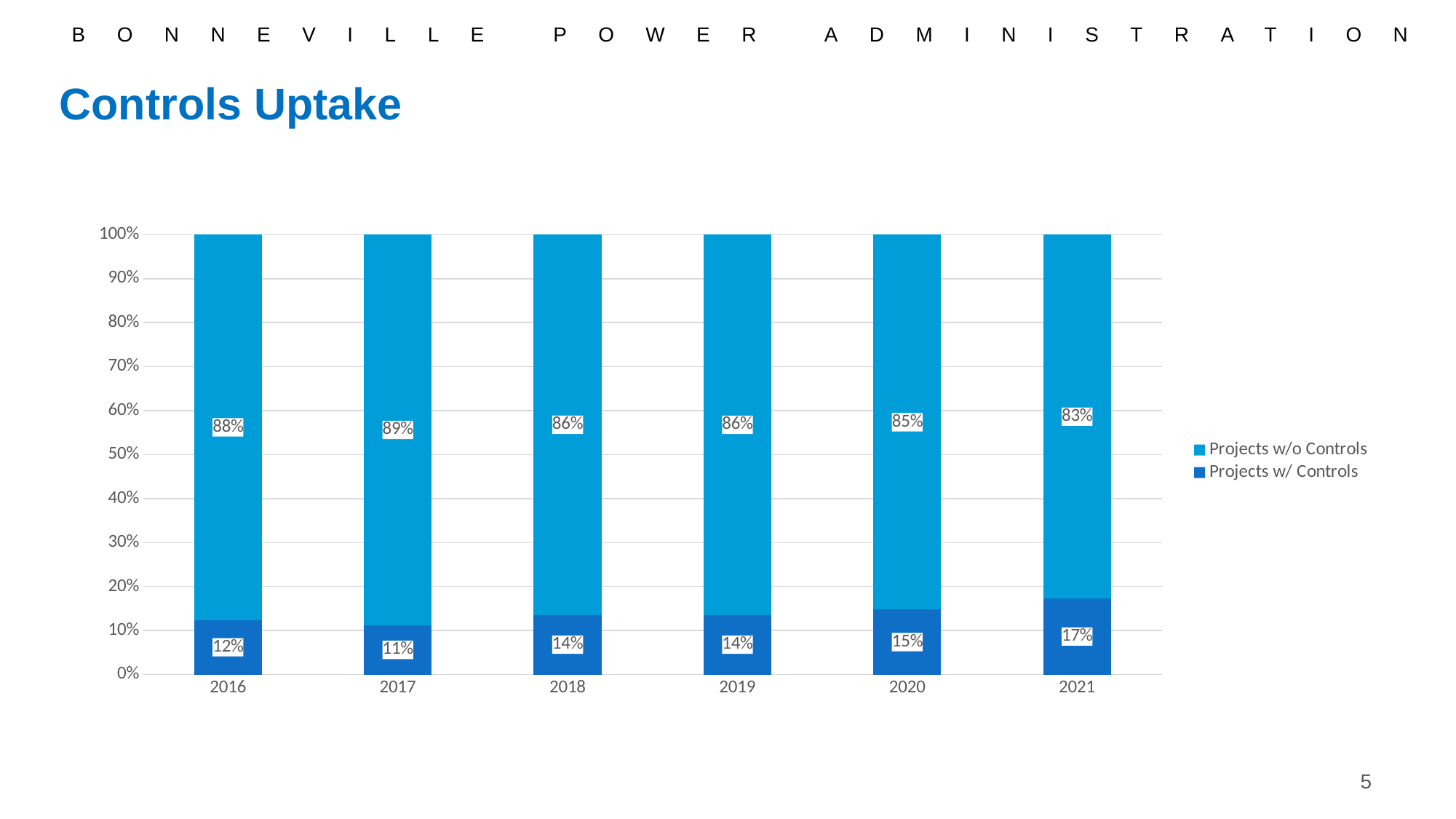
Which is larger: the Projects w/o Controls share in 2017 or in 2020? 2017 Which year has the highest share of Projects w/ Controls? 2021 Does the share of Projects w/ Controls generally rise or fall from 2017 to 2021? Rise What is the value for Projects w/o Controls in 2021? 83% What is the difference between the Projects w/ Controls share in 2021 and in 2016? 5% Which year has the lowest share of Projects w/ Controls? 2017 What percentage of projects had controls in 2016? 12% What is the value for Projects w/ Controls in 2020? 15% How many years are shown on the x axis? 6 How many series does the legend list? 2 What kind of chart is shown on the slide? Stacked bar chart Is the value for Projects w/ Controls in 2021 greater or less than 10%? greater